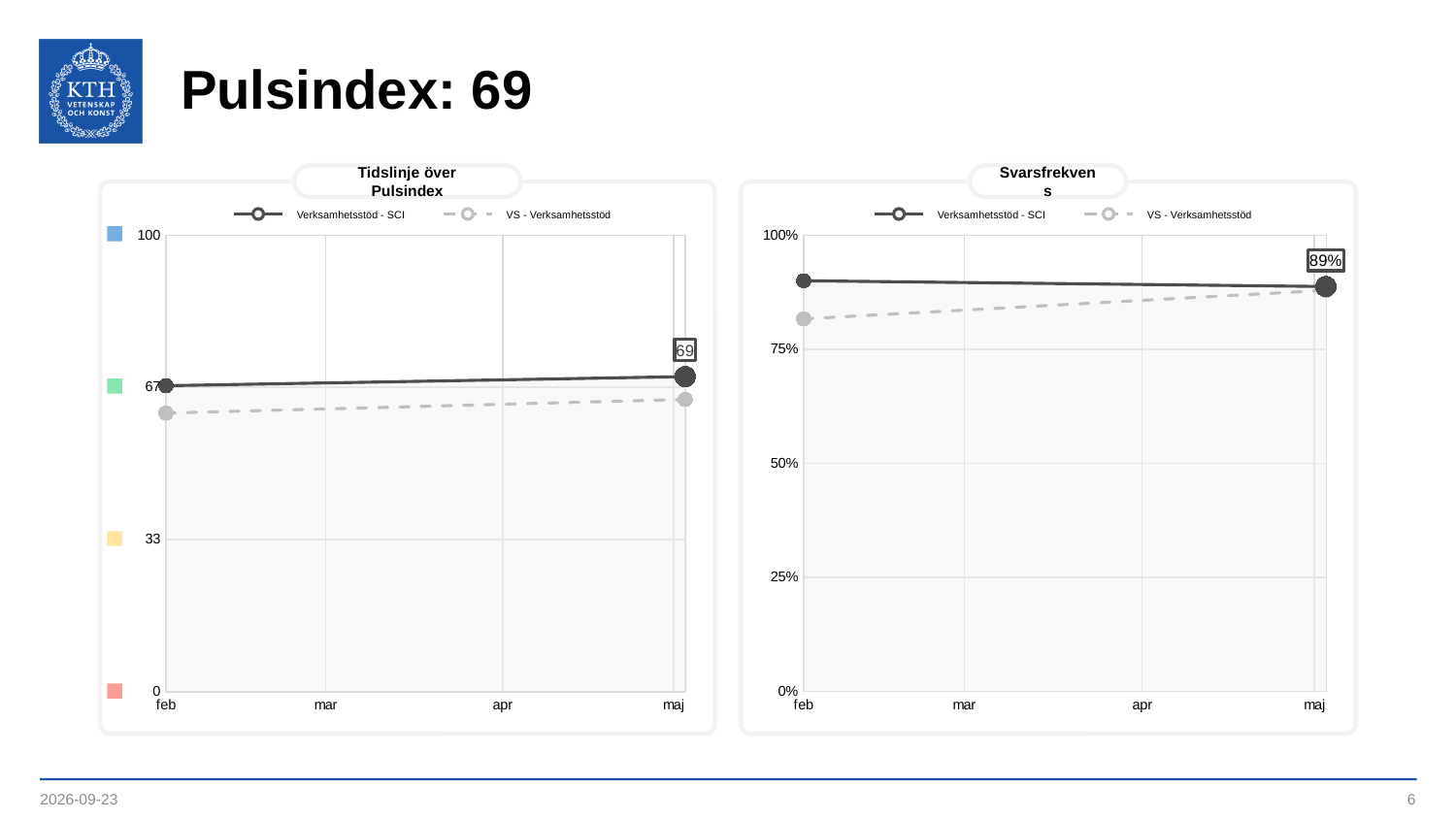
In the 'Svarsfrekvens' chart, does the VS - Verksamhetsstöd line rise or fall from feb to maj? rise In the 'Svarsfrekvens' chart, what is the value for Verksamhetsstöd - SCI in maj? 89% In the 'Tidslinje över Pulsindex' chart, what is the value for Verksamhetsstöd - SCI in maj? 69 How many series does the legend of the 'Svarsfrekvens' chart list? 2 In the 'Tidslinje över Pulsindex' chart, is the value for VS - Verksamhetsstöd in feb greater or less than 67? less In the 'Svarsfrekvens' chart, is the value for Verksamhetsstöd - SCI in feb greater or less than 75%? greater How many months are shown on the x axis of the 'Tidslinje över Pulsindex' chart? 4 What kind of chart is the 'Tidslinje över Pulsindex' chart? line chart What is the title of the chart on the right side of the slide? Svarsfrekvens In the 'Tidslinje över Pulsindex' chart, which series is drawn with a dashed line? VS - Verksamhetsstöd In the 'Svarsfrekvens' chart, is the value for VS - Verksamhetsstöd in feb greater or less than 75%? greater In the 'Tidslinje över Pulsindex' chart, which series has the higher value in maj? Verksamhetsstöd - SCI